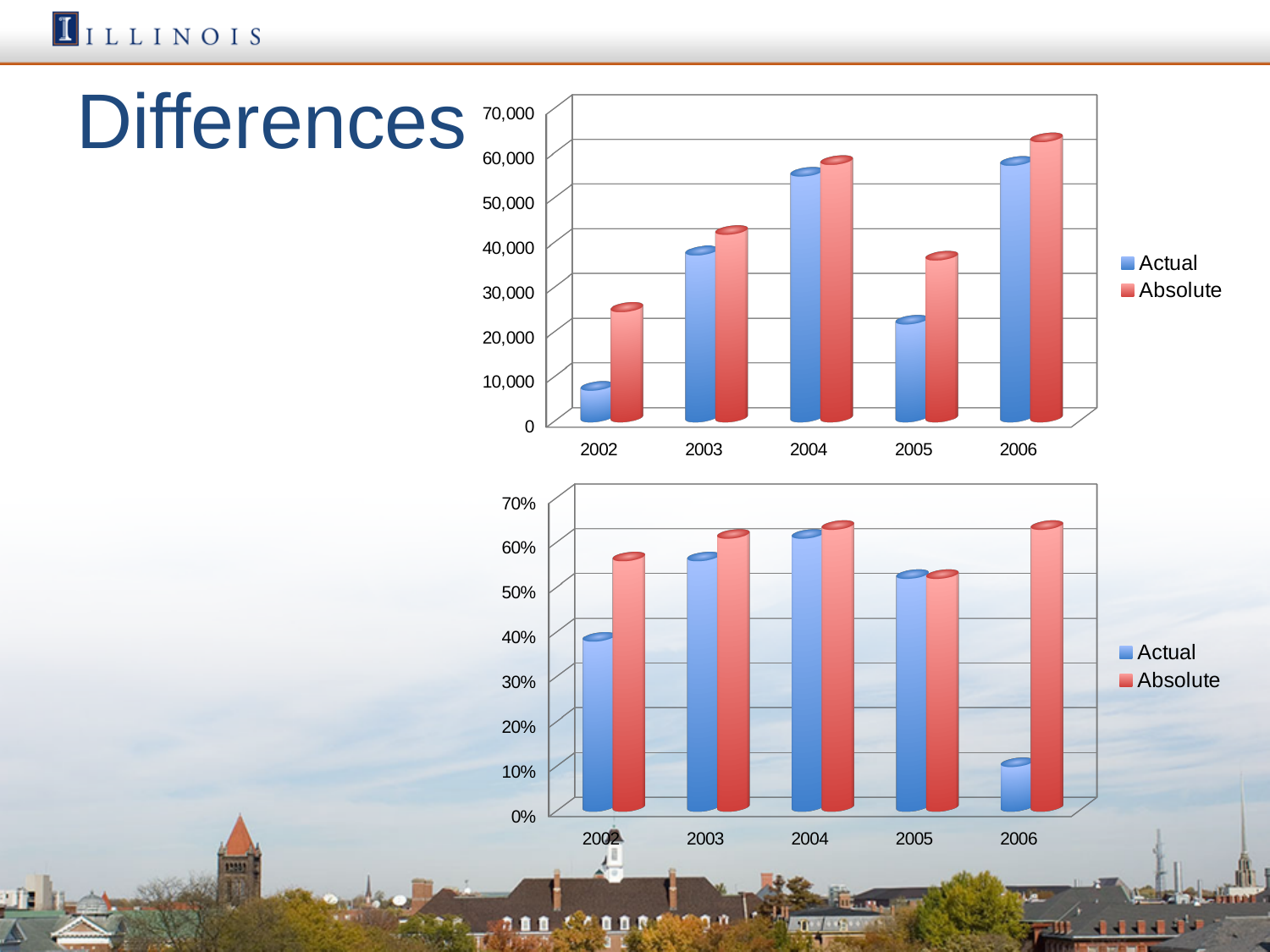
In the bottom chart, is the Absolute value for 2006 greater or less than 60%? greater How many series does the legend of the top chart list? 2 How many years are shown on the x axis of the top chart? 5 In the top chart, which year has the lowest Actual value? 2002 In the top chart, is the Absolute value for 2005 greater or less than 30,000? greater In the bottom chart, which year has the lowest Actual value? 2006 In the top chart, which is larger: the Actual value for 2003 or the Actual value for 2005? 2003 In the bottom chart, is the Actual value for 2002 greater or less than 50%? less What are the two series named in the legend of the bottom chart? Actual and Absolute In the top chart, which year has the highest Absolute value? 2006 What kind of chart is the top chart on the slide? bar chart